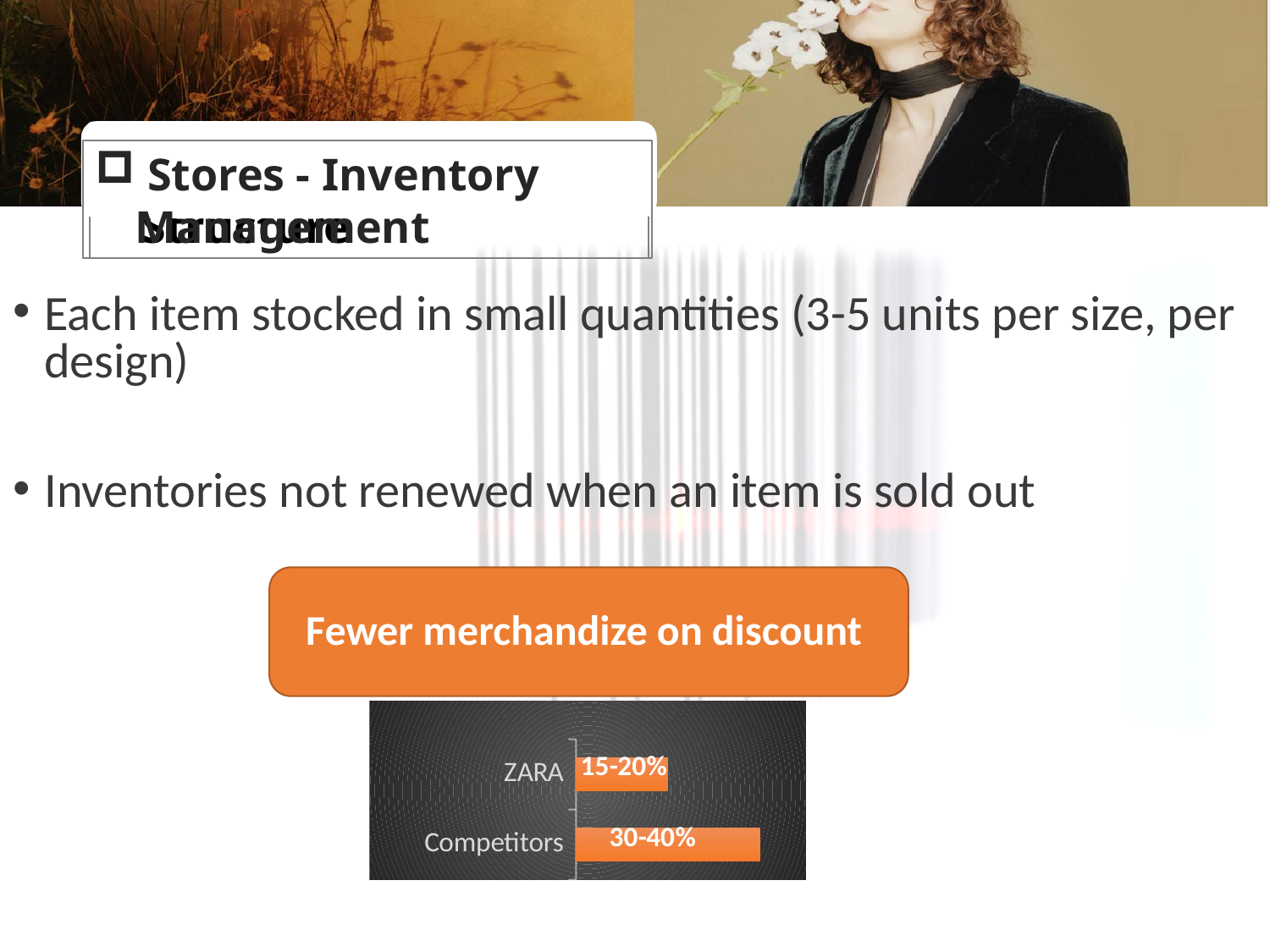
Is the bar for ZARA larger or smaller than the bar for Competitors? smaller What is the value shown for ZARA in the bar chart? 15-20% What colour are the bars in the chart? orange Which category has the longer bar in the chart? Competitors How many categories are plotted in the bar chart? 2 What is the value shown for Competitors in the bar chart? 30-40% What kind of chart is shown on the slide? bar chart Which category has the shorter bar in the chart? ZARA What heading appears in the box directly above the chart? Fewer merchandize on discount